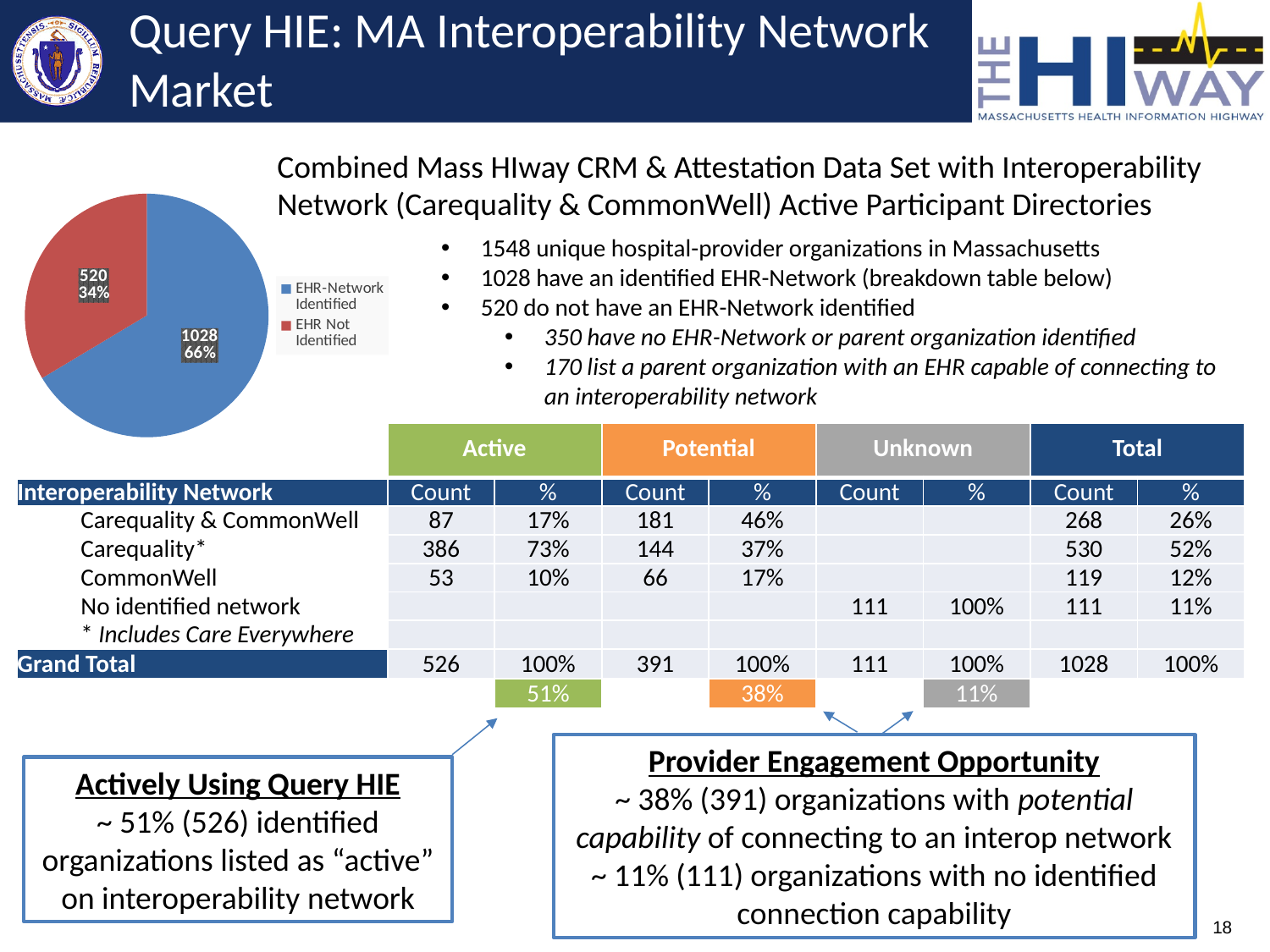
What kind of chart is shown on the left of the slide? pie chart What is the difference in count between the EHR-Network Identified and EHR Not Identified slices? 508 What is the count shown for the EHR Not Identified slice of the pie chart? 520 How many slices does the pie chart have? 2 What percentage of the pie does the EHR Not Identified slice represent? 34% Which is larger in the pie chart: EHR-Network Identified or EHR Not Identified? EHR-Network Identified What percentage of the pie does the EHR-Network Identified slice represent? 66% What is the count shown for the EHR-Network Identified slice of the pie chart? 1028 How many entries does the pie chart's legend list? 2 What colour is the EHR Not Identified slice in the pie chart? red Which slice of the pie chart is the largest? EHR-Network Identified Which slice of the pie chart is the smallest? EHR Not Identified